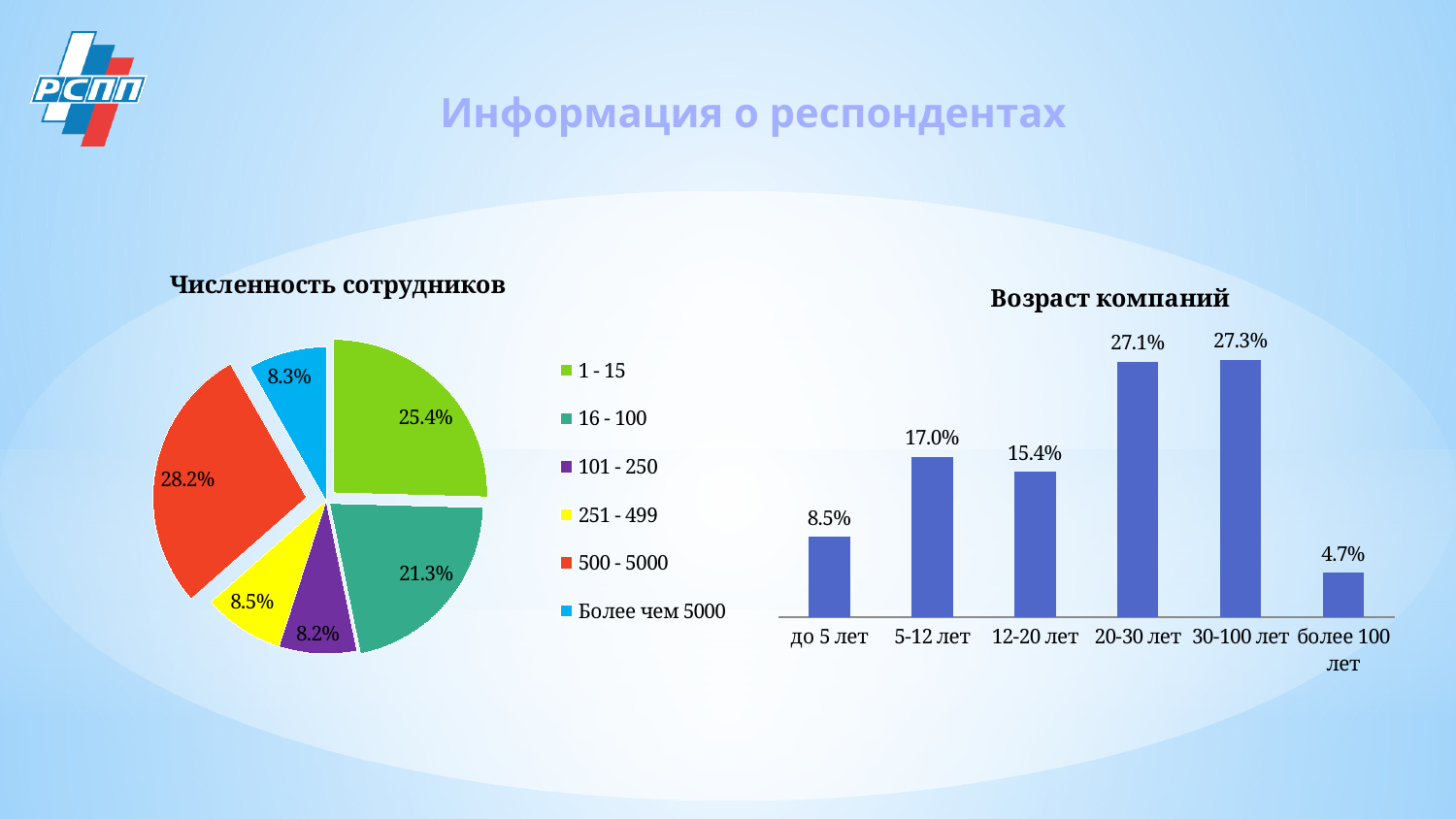
In the bar chart 'Возраст компаний', which category has the lowest value? более 100 лет In the bar chart 'Возраст компаний', which is larger: the value for '5-12 лет' or for '12-20 лет'? 5-12 лет In the pie chart 'Численность сотрудников', what share is shown for the '500 - 5000' category? 28.2% In the pie chart 'Численность сотрудников', what share is shown for the '1 - 15' category? 25.4% What type of chart is 'Возраст компаний'? Bar chart In the bar chart 'Возраст компаний', how many categories are shown on the x axis? 6 In the pie chart 'Численность сотрудников', how many categories does the legend list? 6 In the bar chart 'Возраст компаний', what is the value for 'более 100 лет'? 4.7% In the pie chart 'Численность сотрудников', what is the difference between the '1 - 15' and '16 - 100' shares? 4.1% In the pie chart 'Численность сотрудников', which category has the largest slice? 500 - 5000 In the pie chart 'Численность сотрудников', which category has the smallest slice? 101 - 250 In the bar chart 'Возраст компаний', what is the value for '20-30 лет'? 27.1%